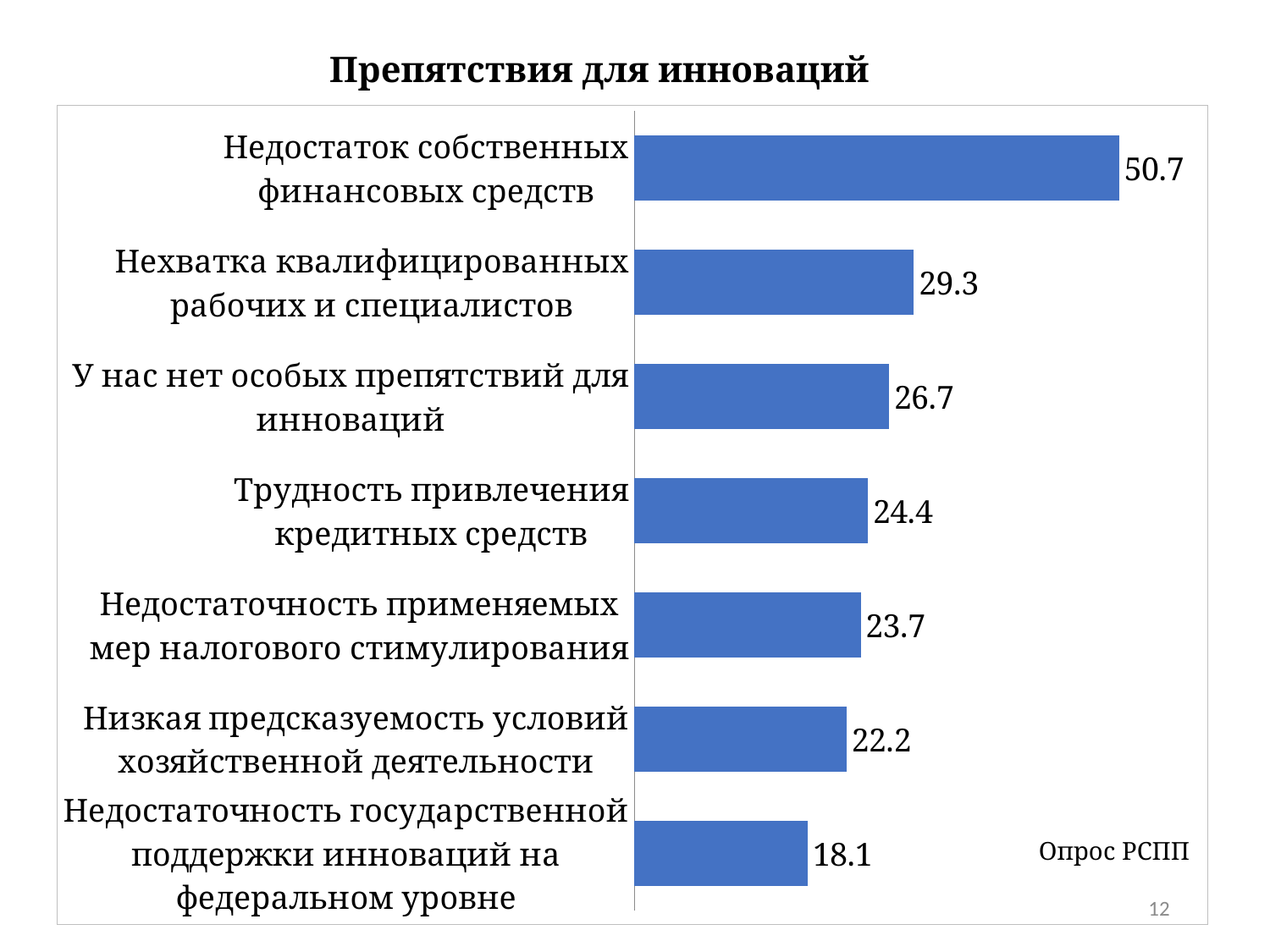
What is the difference between the values for «Недостаток собственных финансовых средств» and «Нехватка квалифицированных рабочих и специалистов»? 21.4 What is the value for «Нехватка квалифицированных рабочих и специалистов»? 29.3 What is the value for «Недостаток собственных финансовых средств»? 50.7 What is the value for «Трудность привлечения кредитных средств»? 24.4 Which category has the highest value? Недостаток собственных финансовых средств What is the title of the chart? Препятствия для инноваций Which is larger: the value for «У нас нет особых препятствий для инноваций» or for «Недостаточность применяемых мер налогового стимулирования»? У нас нет особых препятствий для инноваций What kind of chart is shown on the slide? Bar chart How many categories are shown in the chart? 7 What is the difference between the values for «У нас нет особых препятствий для инноваций» and «Низкая предсказуемость условий хозяйственной деятельности»? 4.5 What is the value for «Недостаточность государственной поддержки инноваций на федеральном уровне»? 18.1 Which category has the lowest value? Недостаточность государственной поддержки инноваций на федеральном уровне